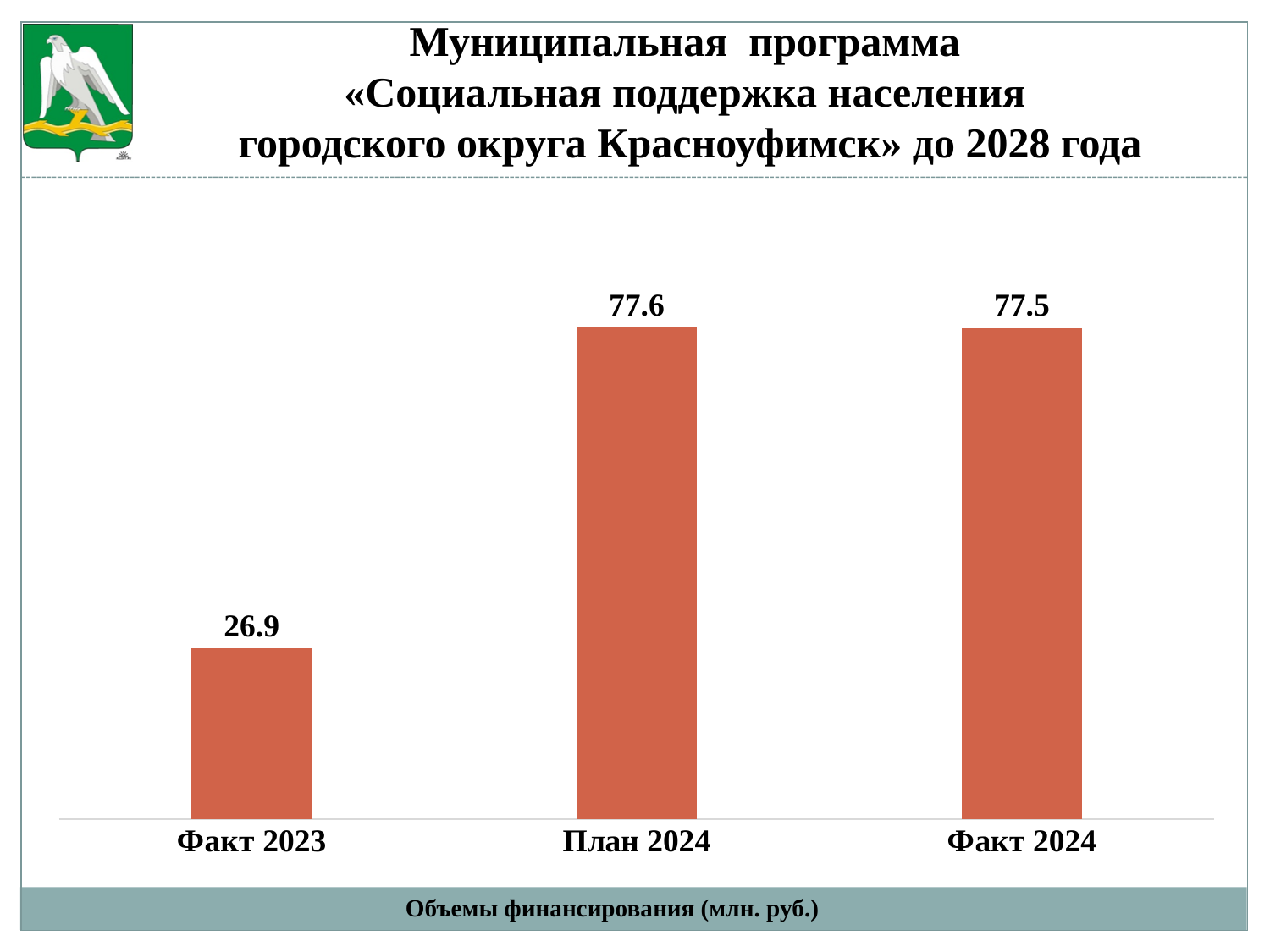
What is the difference between План 2024 and Факт 2024? 0.1 What is the value for План 2024? 77.6 What is the total of all three bars? 182 What colour are the bars on the chart? orange-red What is the value for Факт 2023? 26.9 Which category has the lowest value? Факт 2023 What is the value for Факт 2024? 77.5 Which is larger, Факт 2023 or Факт 2024? Факт 2024 What unit is given for the financing volumes in the caption below the chart? млн. руб. What is the difference between План 2024 and Факт 2023? 50.7 What kind of chart is shown on the slide? bar chart How many categories are shown on the chart? 3